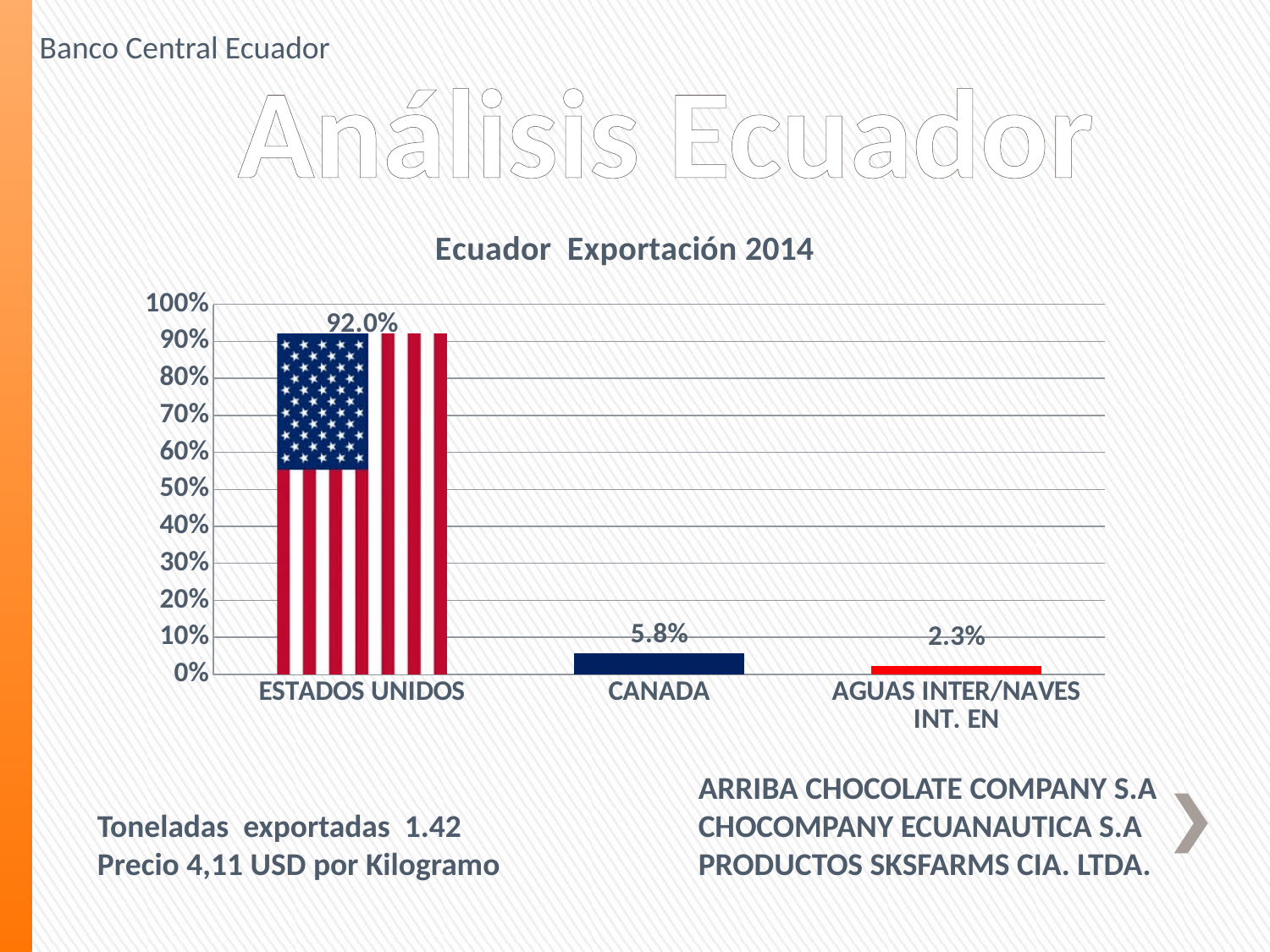
Which category has the highest value in the Ecuador Exportación 2014 chart? ESTADOS UNIDOS What is the value for ESTADOS UNIDOS in the Ecuador Exportación 2014 chart? 92.0% Is the value for ESTADOS UNIDOS in the Ecuador Exportación 2014 chart greater or less than 90%? greater Which category has the lowest value in the Ecuador Exportación 2014 chart? AGUAS INTER/NAVES INT. EN What is the value for AGUAS INTER/NAVES INT. EN in the Ecuador Exportación 2014 chart? 2.3% What is the value for CANADA in the Ecuador Exportación 2014 chart? 5.8% What is the title of the chart on the slide? Ecuador Exportación 2014 What kind of chart is the Ecuador Exportación 2014 chart? bar chart Which has a larger value in the Ecuador Exportación 2014 chart, CANADA or AGUAS INTER/NAVES INT. EN? CANADA What is the difference between the values for ESTADOS UNIDOS and CANADA in the Ecuador Exportación 2014 chart? 86.2% What is the difference between the values for CANADA and AGUAS INTER/NAVES INT. EN in the Ecuador Exportación 2014 chart? 3.5% How many categories are shown in the Ecuador Exportación 2014 chart? 3